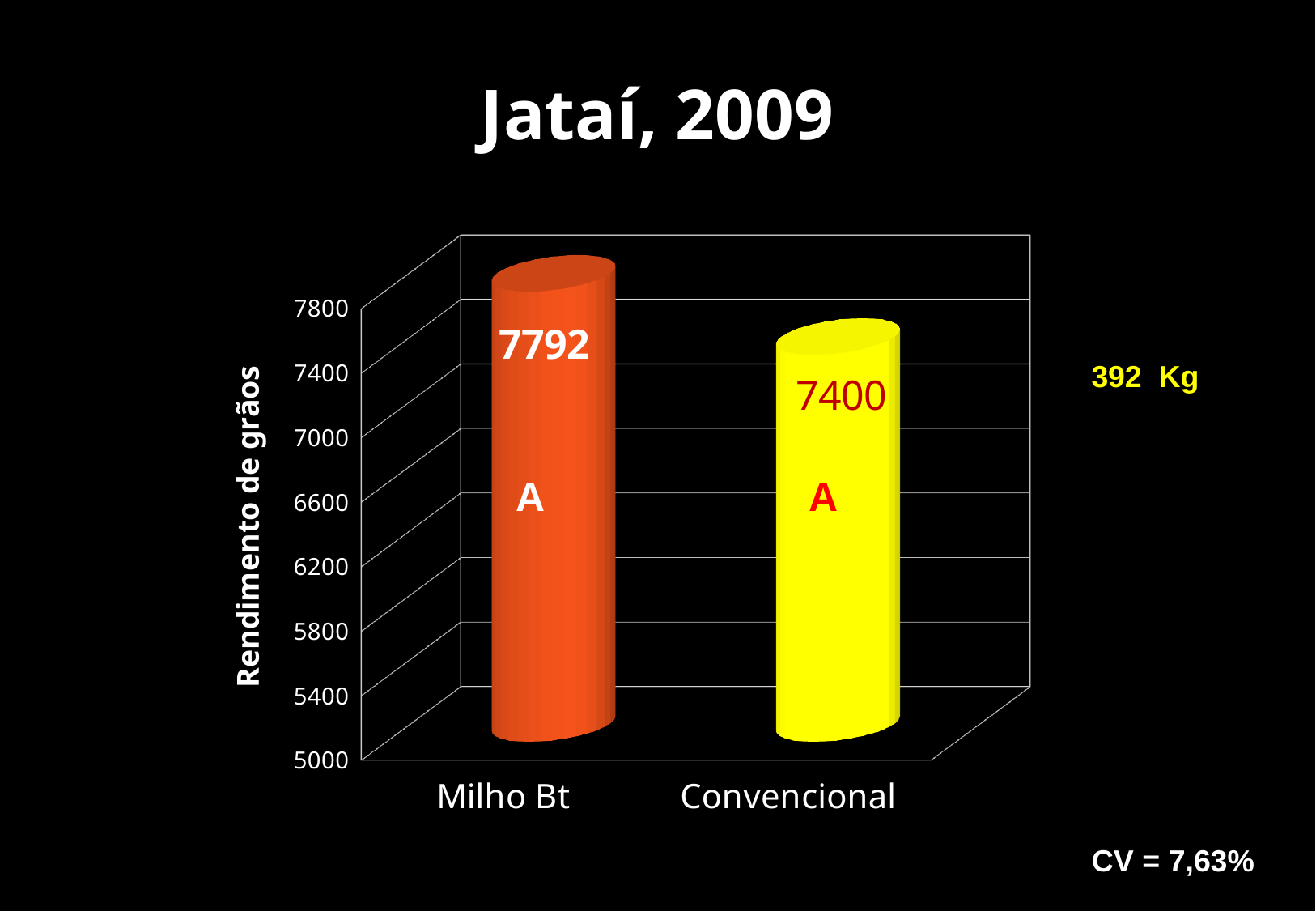
What kind of chart is shown on the slide? bar chart What is the grain yield value shown for Milho Bt? 7792 What is the label of the vertical axis? Rendimento de grãos Is the value for Milho Bt greater or less than the value for Convencional? greater Which category has the higher grain yield? Milho Bt How many categories are shown on the x axis? 2 What is the difference between the Milho Bt and Convencional yields? 392 Is the value for Convencional greater or less than 7000? greater Which category has the lower grain yield? Convencional What is the grain yield value shown for Convencional? 7400 What CV value is printed on the slide? CV = 7,63% What is the title of the chart? Jataí, 2009